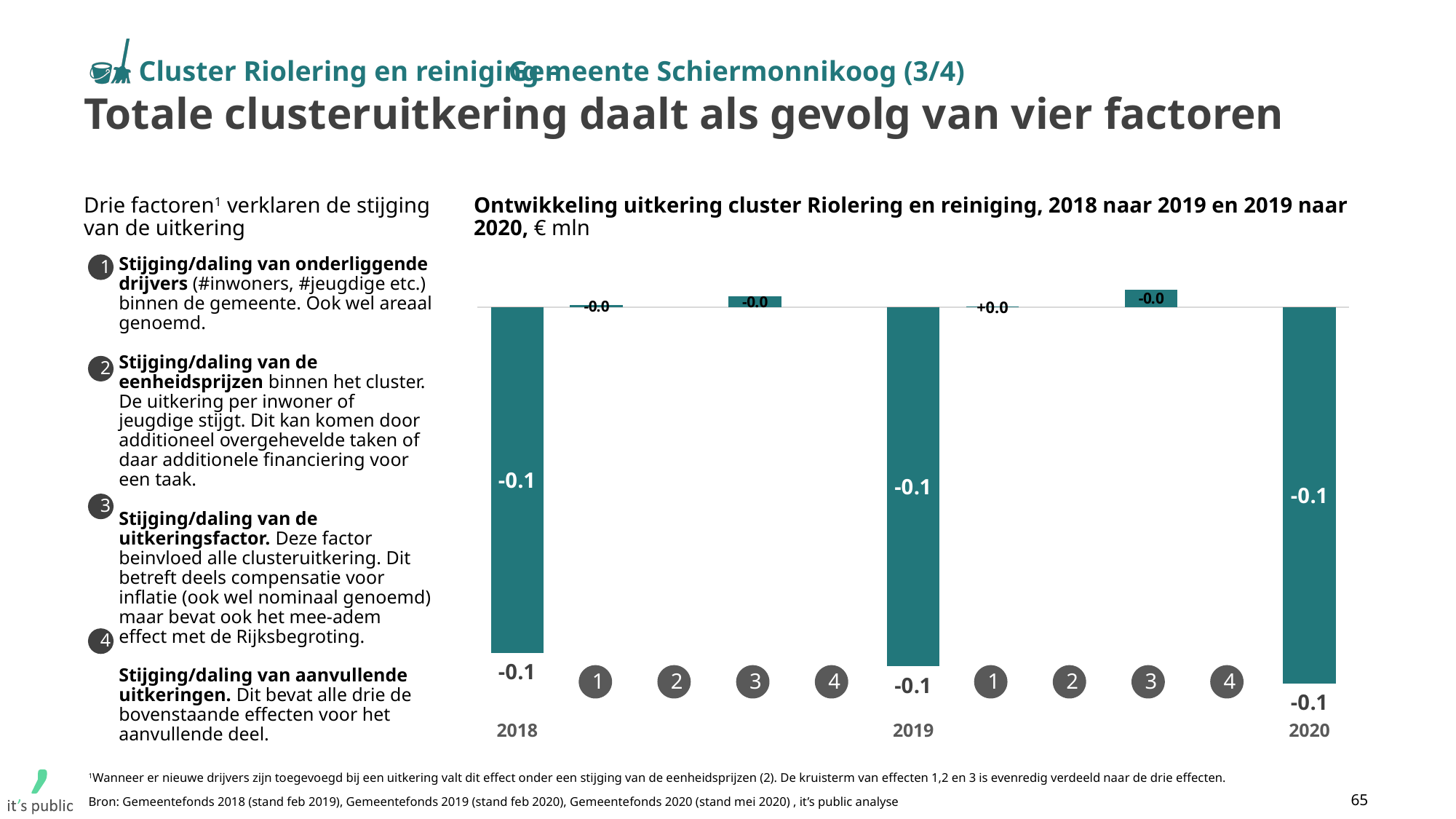
What is the title of the chart? Ontwikkeling uitkering cluster Riolering en reiniging, 2018 naar 2019 en 2019 naar 2020, € mln What is the labelled value of factor 1 in the 2019 to 2020 step of the chart? +0.0 What is the value of the 2018 bar in the chart? -0.1 What is the labelled value of factor 3 in the 2019 to 2020 step of the chart? -0.0 What is the labelled value of factor 1 in the 2018 to 2019 step of the chart? -0.0 How many year bars (2018, 2019, 2020) are shown in the chart? 3 What is the value of the 2019 bar in the chart? -0.1 In what unit are the values in the chart expressed? € mln How many numbered factors are shown between each pair of year bars in the chart? 4 What is the value of the 2020 bar in the chart? -0.1 What is the labelled value of factor 3 in the 2018 to 2019 step of the chart? -0.0 What kind of chart is shown on the slide? Bar chart